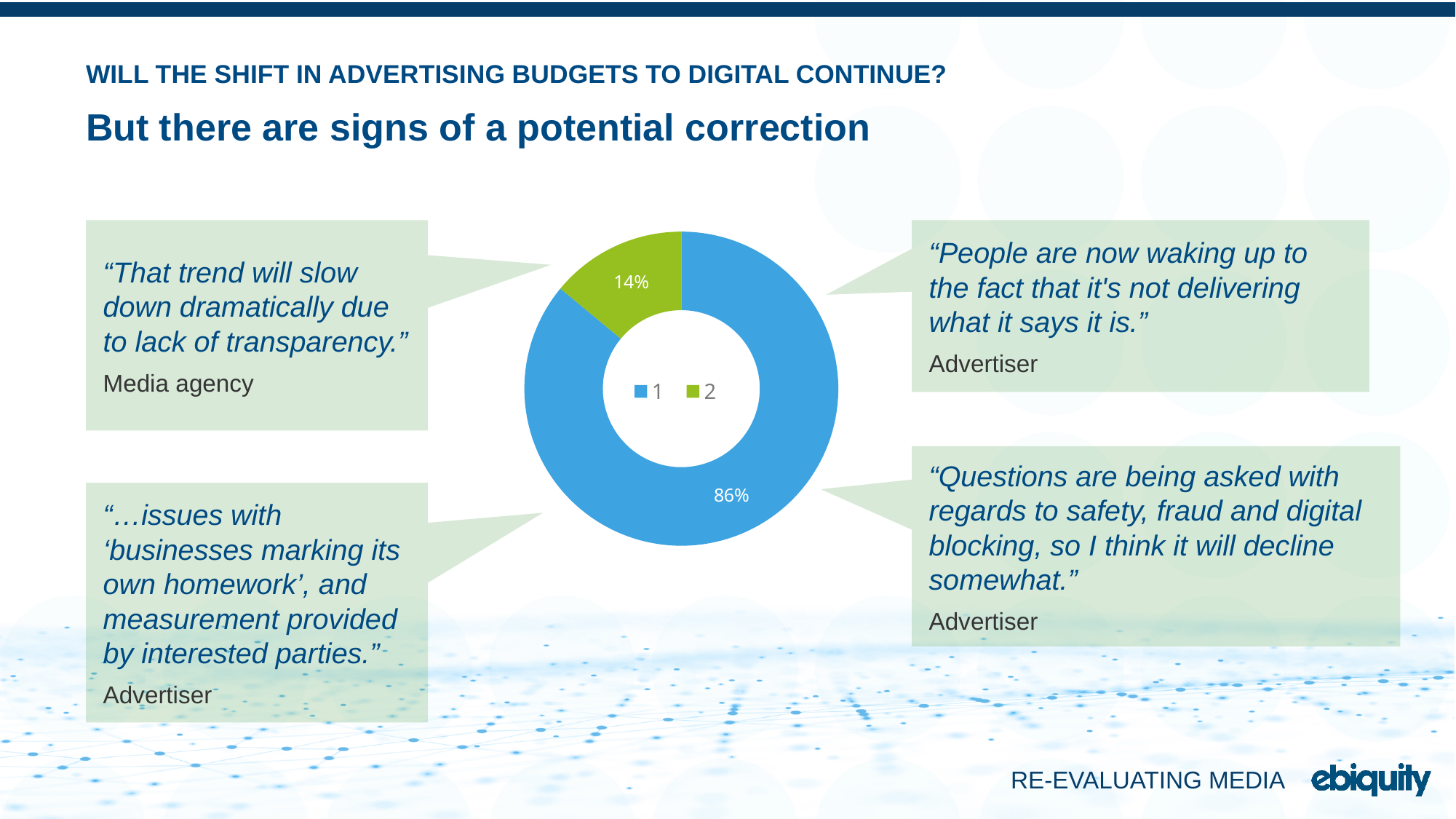
Which slice of the donut chart is the smallest? 2 What percentage is shown for the blue slice labelled 1? 86% What are the two legend entries shown in the centre of the donut chart? 1 and 2 What is the difference in percentage points between slice 1 and slice 2? 72 What share of the donut chart does slice 1 represent? 86% Which slice of the donut chart is the largest? 1 What colour is the slice labelled 2 in the donut chart? Green How many slices does the donut chart have? 2 What kind of chart is shown on the slide? Pie chart (donut) Which is larger, slice 1 or slice 2? 1 How many entries does the chart legend list? 2 What percentage is shown for the green slice labelled 2? 14%